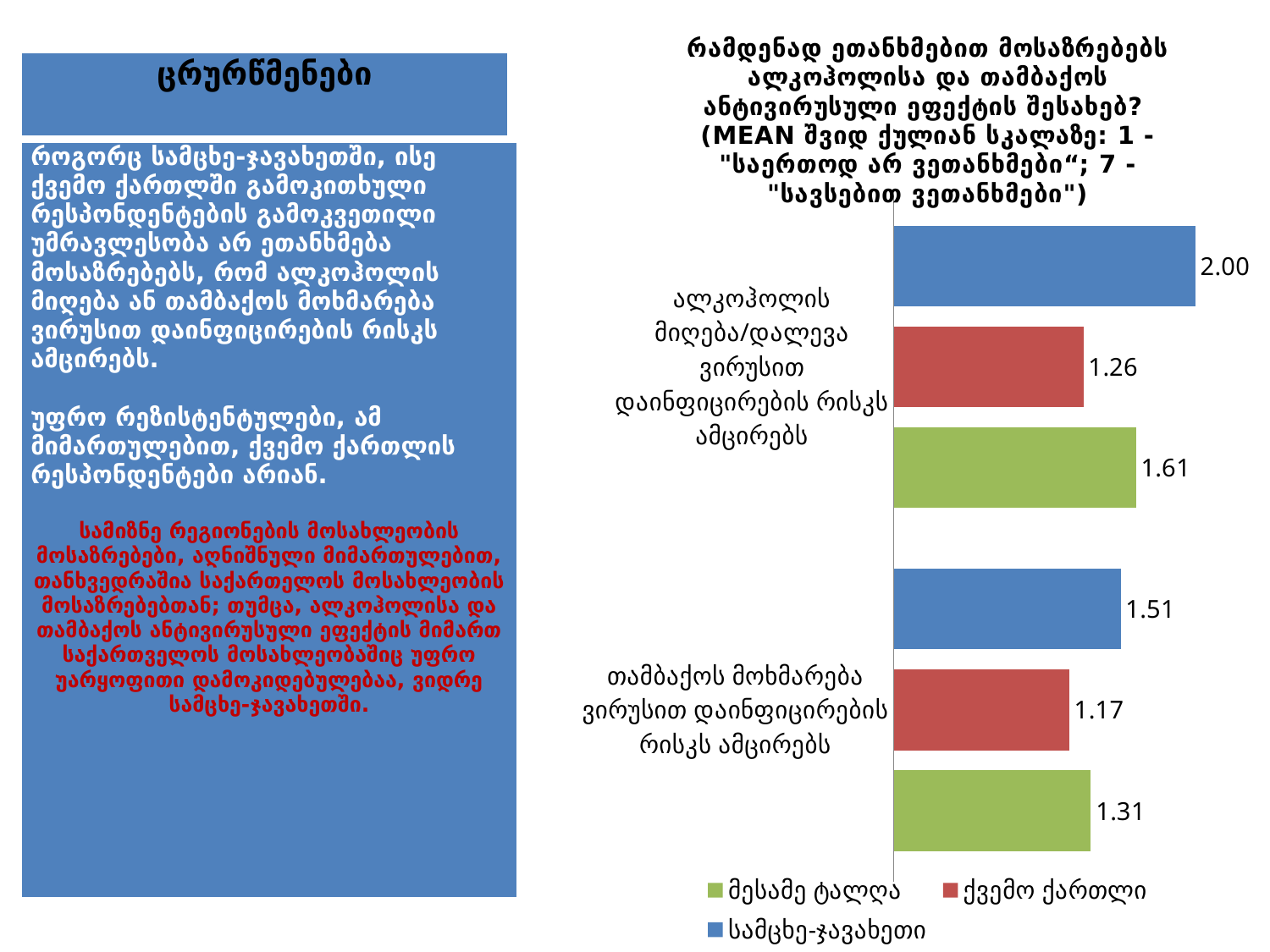
What is the value for სამცხე-ჯავახეთი in the category "ალკოჰოლის მიღება/დალევა ვირუსით დაინფიცირების რისკს ამცირებს"? 2.00 What is the value for მესამე ტალღა in the category "ალკოჰოლის მიღება/დალევა ვირუსით დაინფიცირების რისკს ამცირებს"? 1.61 What is the value for ქვემო ქართლი in the category "თამბაქოს მოხმარება ვირუსით დაინფიცირების რისკს ამცირებს"? 1.17 What is the difference between the სამცხე-ჯავახეთი and მესამე ტალღა values in the category "თამბაქოს მოხმარება ვირუსით დაინფიცირების რისკს ამცირებს"? 0.20 How many categories are shown on the chart? 2 How many series does the legend list? 3 What kind of chart is shown on the slide? bar chart What is the value for მესამე ტალღა in the category "თამბაქოს მოხმარება ვირუსით დაინფიცირების რისკს ამცირებს"? 1.31 Which series has the highest value in the category "ალკოჰოლის მიღება/დალევა ვირუსით დაინფიცირების რისკს ამცირებს"? სამცხე-ჯავახეთი Which series has the lowest value in the category "თამბაქოს მოხმარება ვირუსით დაინფიცირების რისკს ამცირებს"? ქვემო ქართლი What is the difference between the სამცხე-ჯავახეთი and ქვემო ქართლი values in the category "ალკოჰოლის მიღება/დალევა ვირუსით დაინფიცირების რისკს ამცირებს"? 0.74 Which is larger: the ქვემო ქართლი value for the alcohol category or the ქვემო ქართლი value for the tobacco category? the alcohol category (1.26)